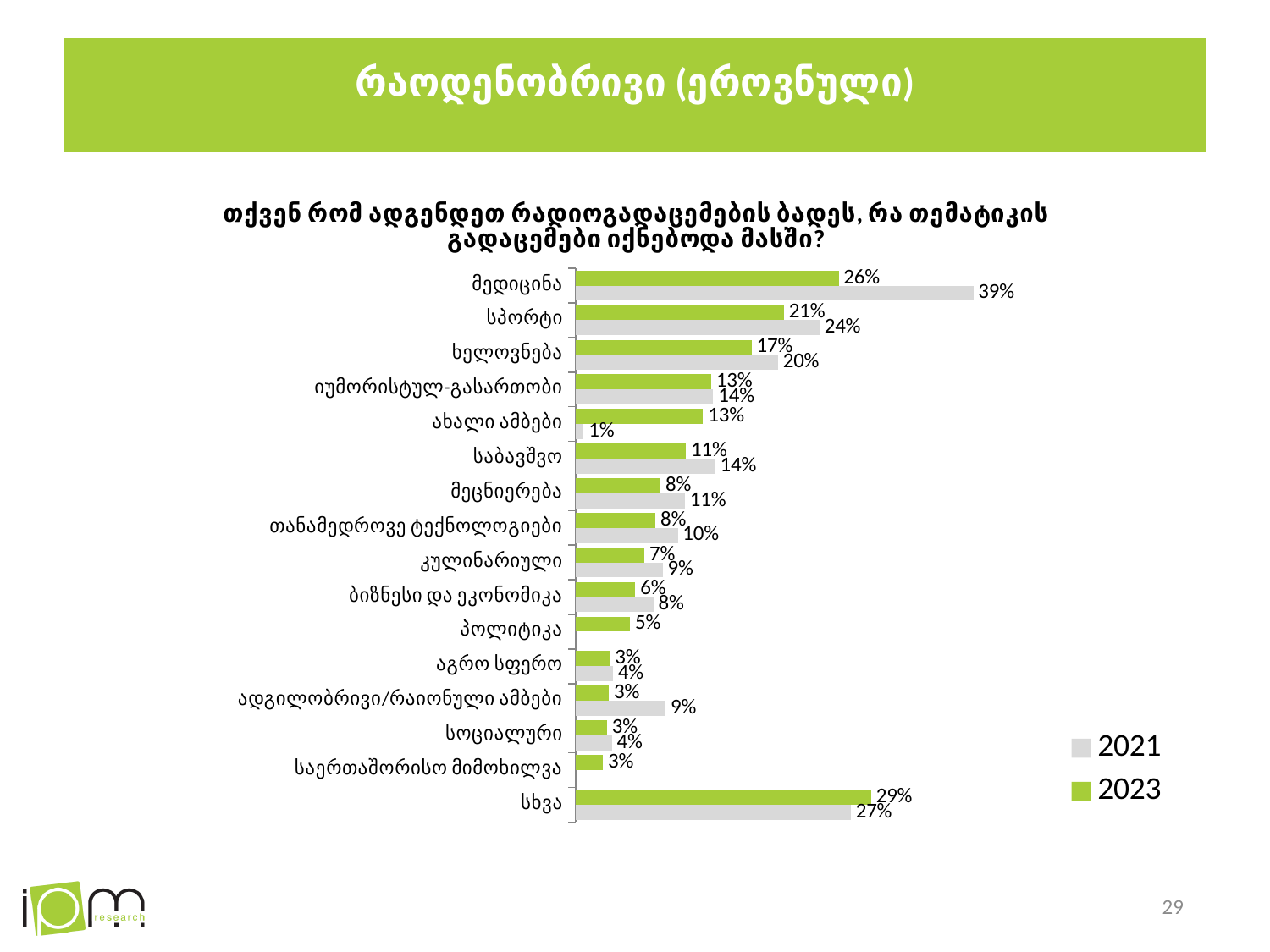
What is the difference between the 2021 and 2023 values for მედიცინა? 13% What is the 2021 value for მედიცინა? 39% What is the 2021 value for ახალი ამბები? 1% What is the 2023 value for სხვა? 29% Which is larger for ადგილობრივი/რაიონული ამბები, the 2021 value or the 2023 value? 2021 What is the 2023 value for სპორტი? 21% What kind of chart is shown on the slide? Bar chart Which category has the lowest 2021 value? ახალი ამბები Which colour represents the 2023 series in the legend? Green How many series does the legend list? 2 How many categories are shown on the chart? 16 Which category has the highest 2021 value? მედიცინა